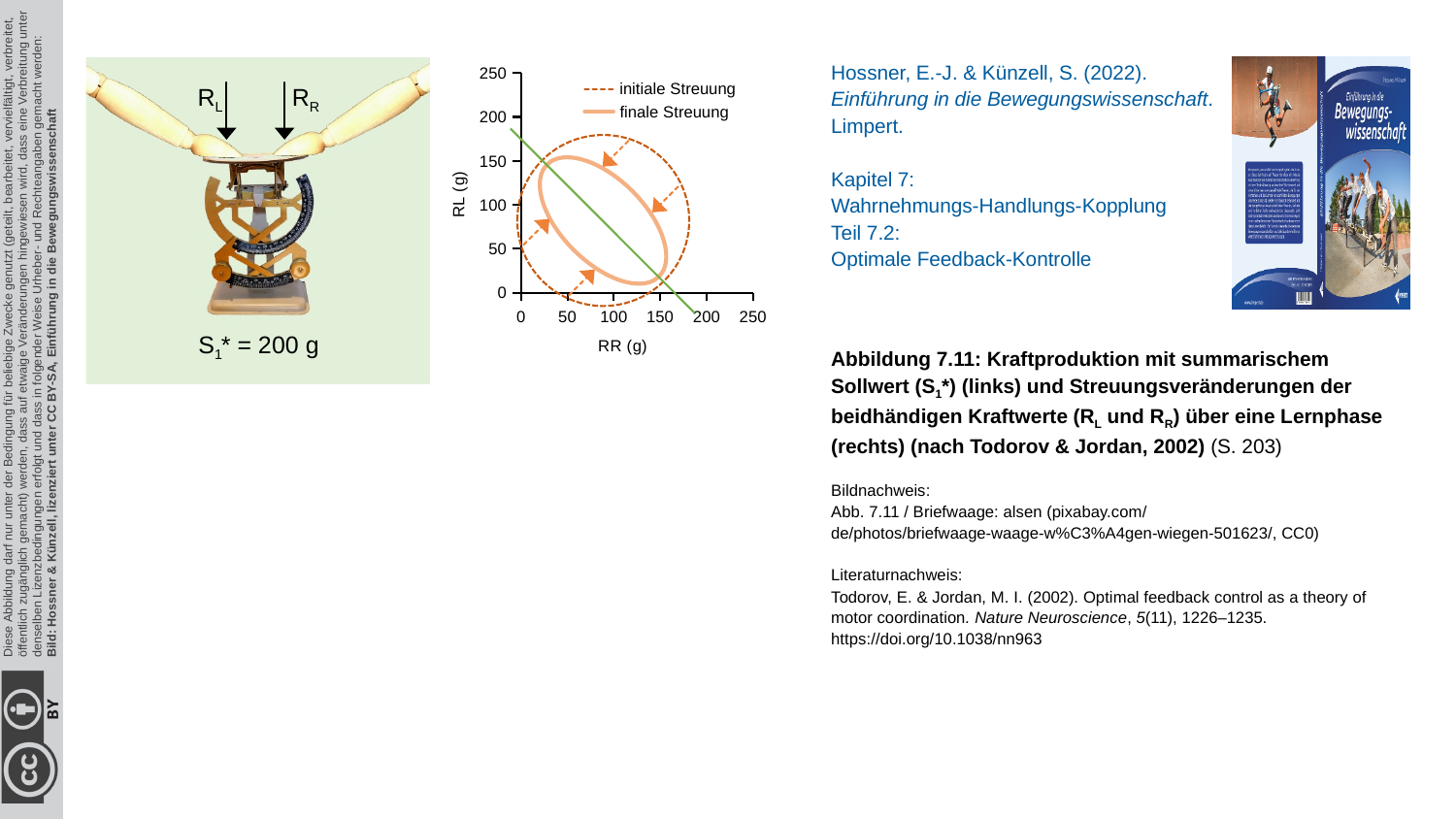
What are the two entries in the chart's legend? initiale Streuung, finale Streuung What is the maximum value shown on the x axis of the chart? 250 Which legend entry is drawn with a dashed line in the chart? initiale Streuung What is the maximum value shown on the y axis of the chart? 250 What is the label of the y axis of the chart? RL (g) How many series does the legend of the chart list? 2 What is the tick interval on the x axis of the chart? 50 What is the label of the x axis of the chart? RR (g)